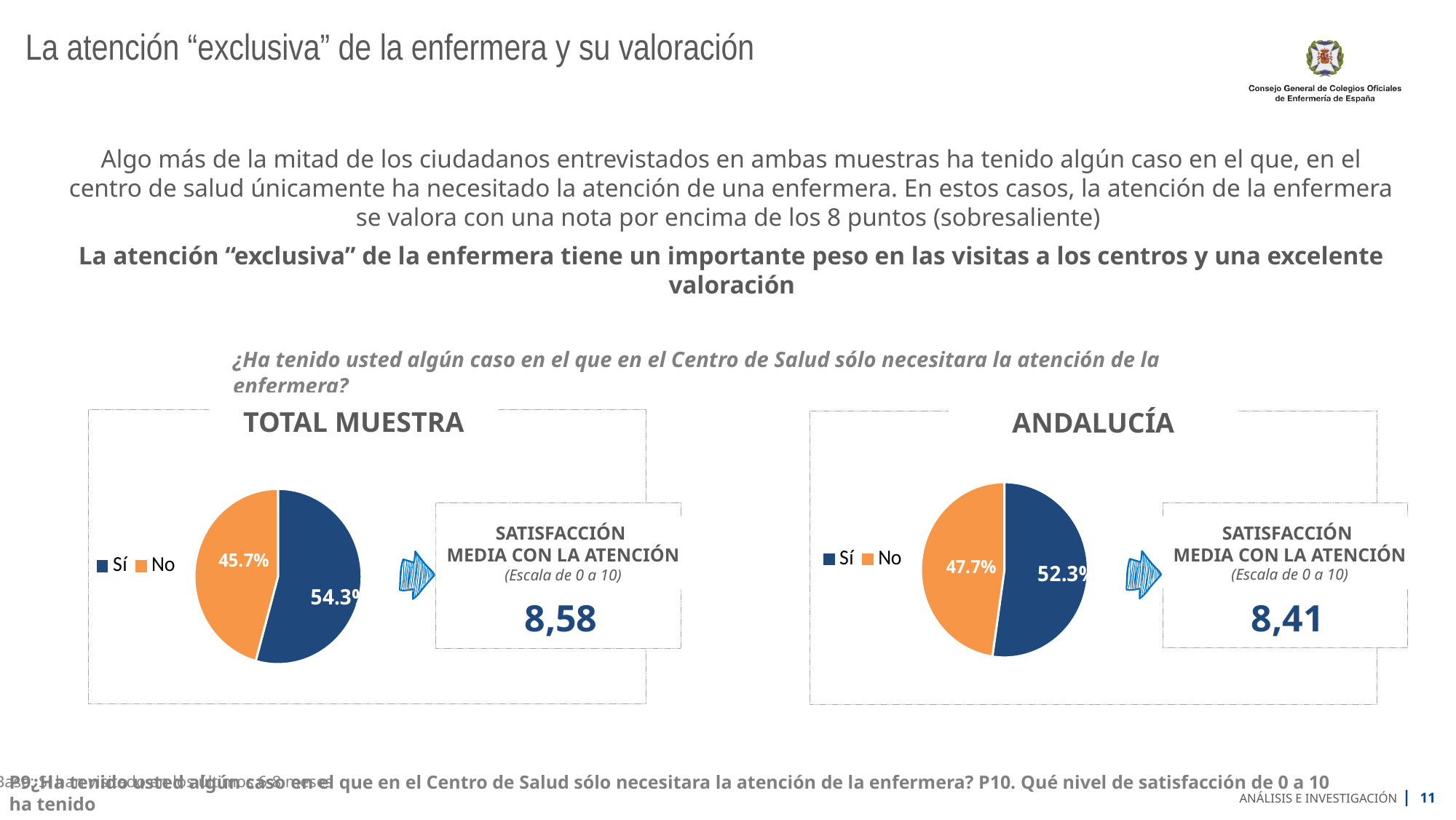
In the ANDALUCÍA pie chart, which slice is the smallest? No In the TOTAL MUESTRA pie chart, which slice is larger, Sí or No? Sí How many entries does the legend of the TOTAL MUESTRA pie chart list? 2 In the ANDALUCÍA pie chart, what percentage answered Sí? 52.3% In the TOTAL MUESTRA pie chart, what percentage answered No? 45.7% In the ANDALUCÍA pie chart, what is the difference between the Sí and No percentages? 4.6% How many slices does the ANDALUCÍA pie chart have? 2 In the TOTAL MUESTRA pie chart, what is the difference between the Sí and No percentages? 8.6% In the ANDALUCÍA pie chart, what colour is the Sí slice? Dark blue In the TOTAL MUESTRA pie chart, what percentage answered Sí? 54.3% In the ANDALUCÍA pie chart, what percentage answered No? 47.7% What kind of chart is used under TOTAL MUESTRA? Pie chart